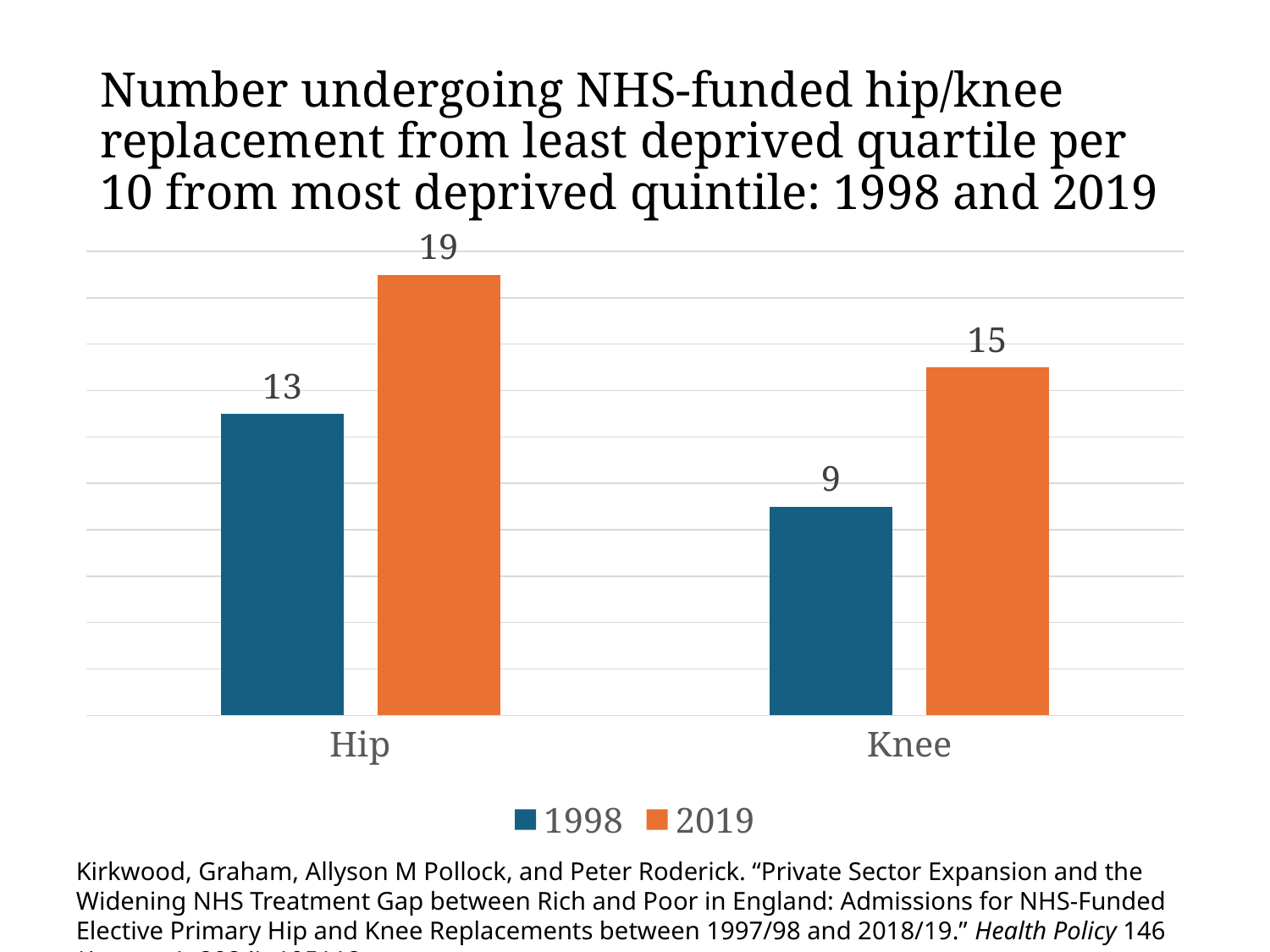
What is the value for Knee in 2019? 15 Which is larger, the 2019 value for Hip or the 2019 value for Knee? Hip What is the value for Hip in 1998? 13 What is the difference between the Knee values for 2019 and 1998? 6 Which bar has the highest value on the chart? Hip, 2019 How many series does the legend list? 2 What is the value for Hip in 2019? 19 What is the difference between the Hip values for 2019 and 1998? 6 Which bar has the lowest value on the chart? Knee, 1998 What kind of chart is shown on the slide? Bar chart What is the value for Knee in 1998? 9 How many categories are shown on the x axis? 2